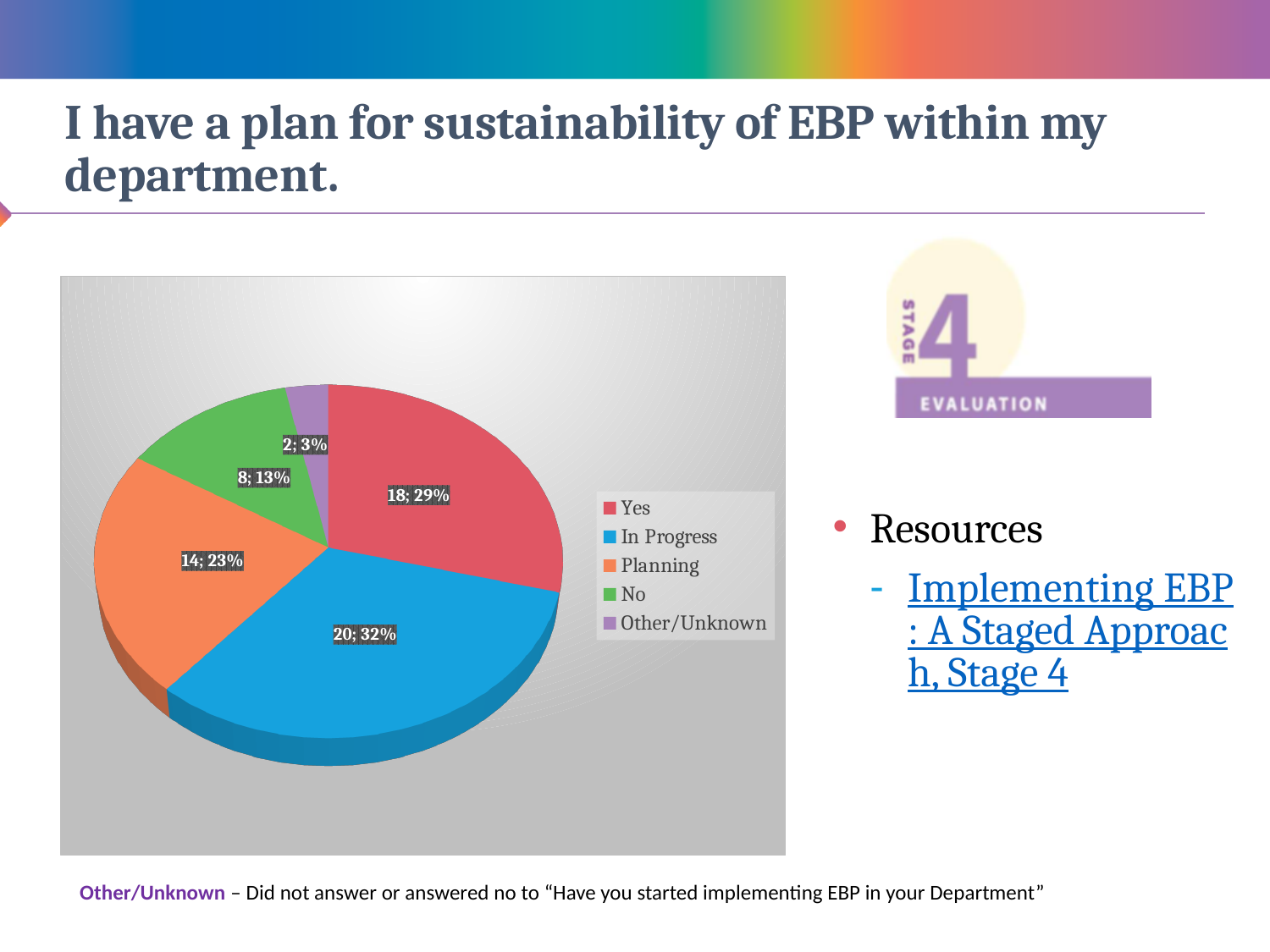
What percentage of the pie does the "No" slice represent? 13% What is the count for the "In Progress" slice? 20 What type of chart is shown on the slide? Pie chart What colour is the "Yes" slice in the pie chart? Red Which category has the largest slice of the pie? In Progress Which is larger, the "Planning" slice or the "No" slice? Planning What is the count for the "Planning" slice? 14 What is the difference in count between "In Progress" and "Yes"? 2 What is the count for the "Other/Unknown" slice? 2 How many categories does the pie chart show? 5 Which category has the smallest slice of the pie? Other/Unknown What percentage of the pie does the "Yes" slice represent? 29%